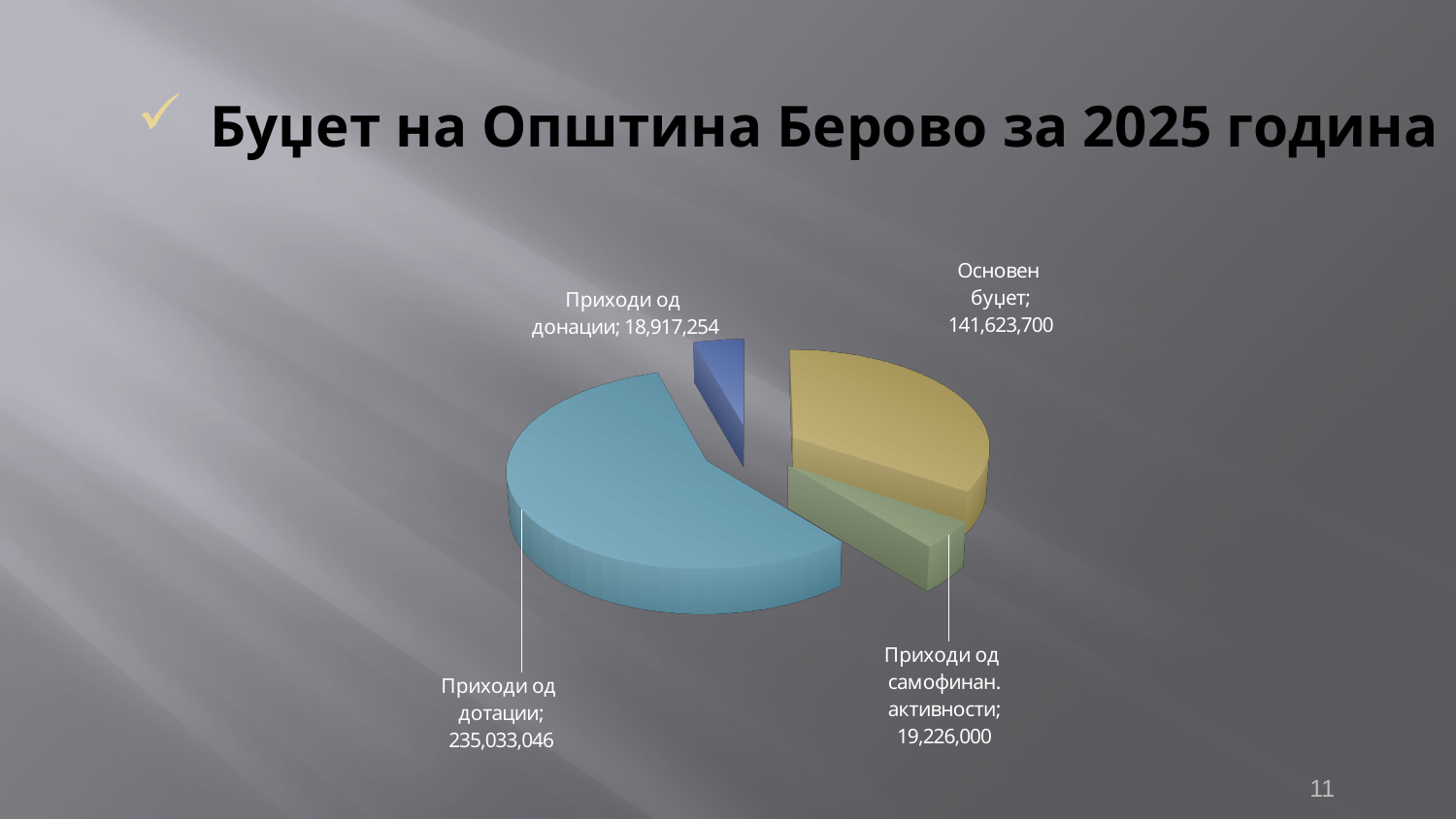
Which category has the smallest value? Приходи од донации How many slices does the pie chart have? 4 What kind of chart is shown on the slide? Pie chart What is the total of all four slices? 414,800,000 What is the value for Приходи од дотации? 235,033,046 Which is larger, Приходи од донации or Приходи од самофинан. активности? Приходи од самофинан. активности Which category has the largest slice of the pie? Приходи од дотации What is the title of the slide containing the chart? Буџет на Општина Берово за 2025 година What is the value for Приходи од донации? 18,917,254 What is the difference between Приходи од дотации and Основен буџет? 93,409,346 What is the value for Приходи од самофинан. активности? 19,226,000 What is the value for Основен буџет? 141,623,700